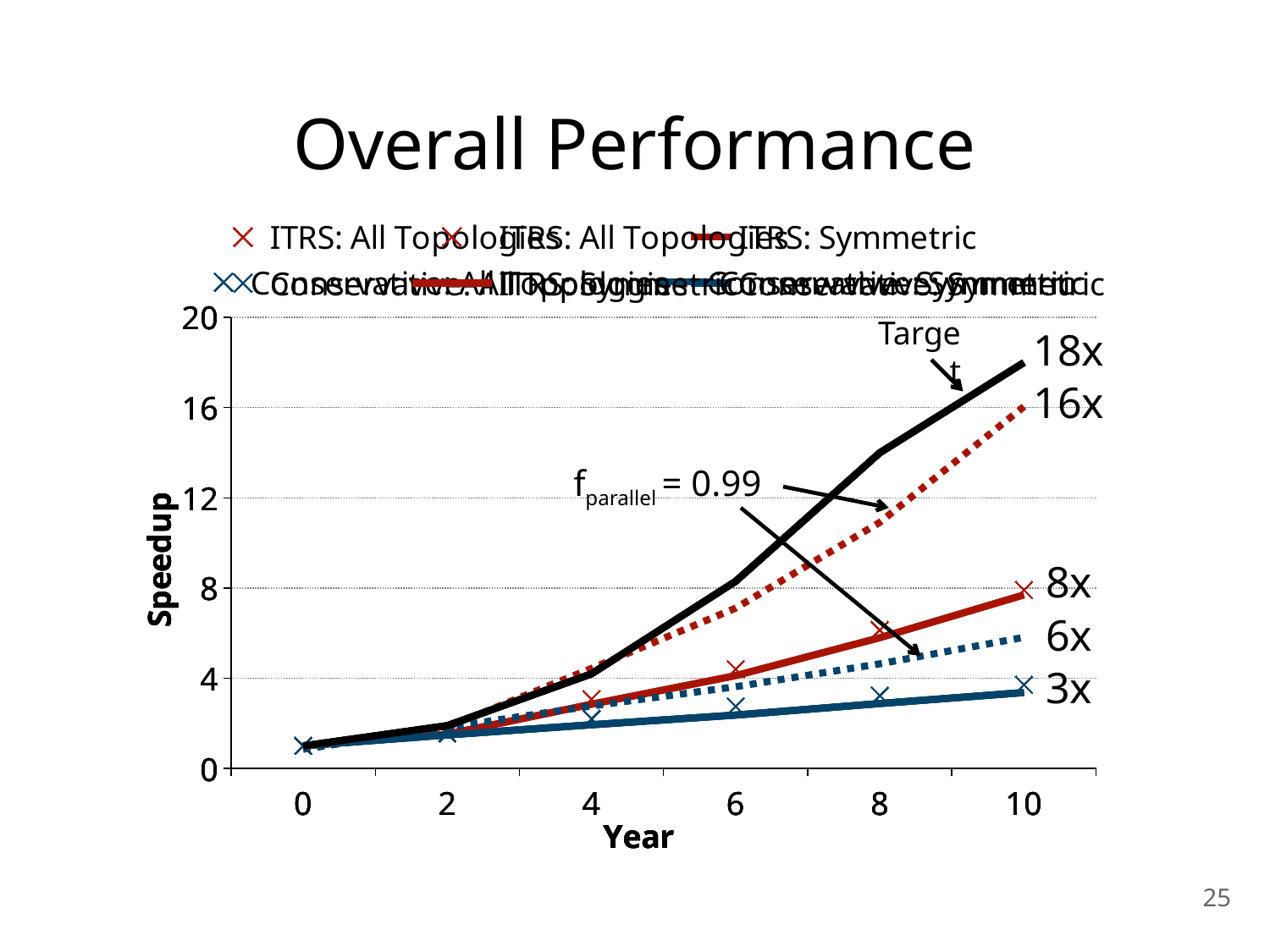
Which line has the lowest speedup at year 10? the solid blue line (3x) Is the value of the Target line at year 8 greater or less than 12? greater What speedup does the line labelled 'Target' reach at year 10? 18x What is the difference between the Target speedup and the red dotted line's speedup at year 10? 2x What speedup does the red dotted line reach at year 10? 16x What is the label on the y axis of the chart? Speedup What is the label on the x axis of the chart? Year Do the speedup values rise or fall as the year increases? rise At year 10, which is larger: the speedup of the solid red line or the dotted blue line? the solid red line (8x) Which line has the highest speedup at year 10? Target (black solid line, 18x) What speedup does the solid blue line reach at year 10? 3x What kind of chart is shown on the slide? line chart